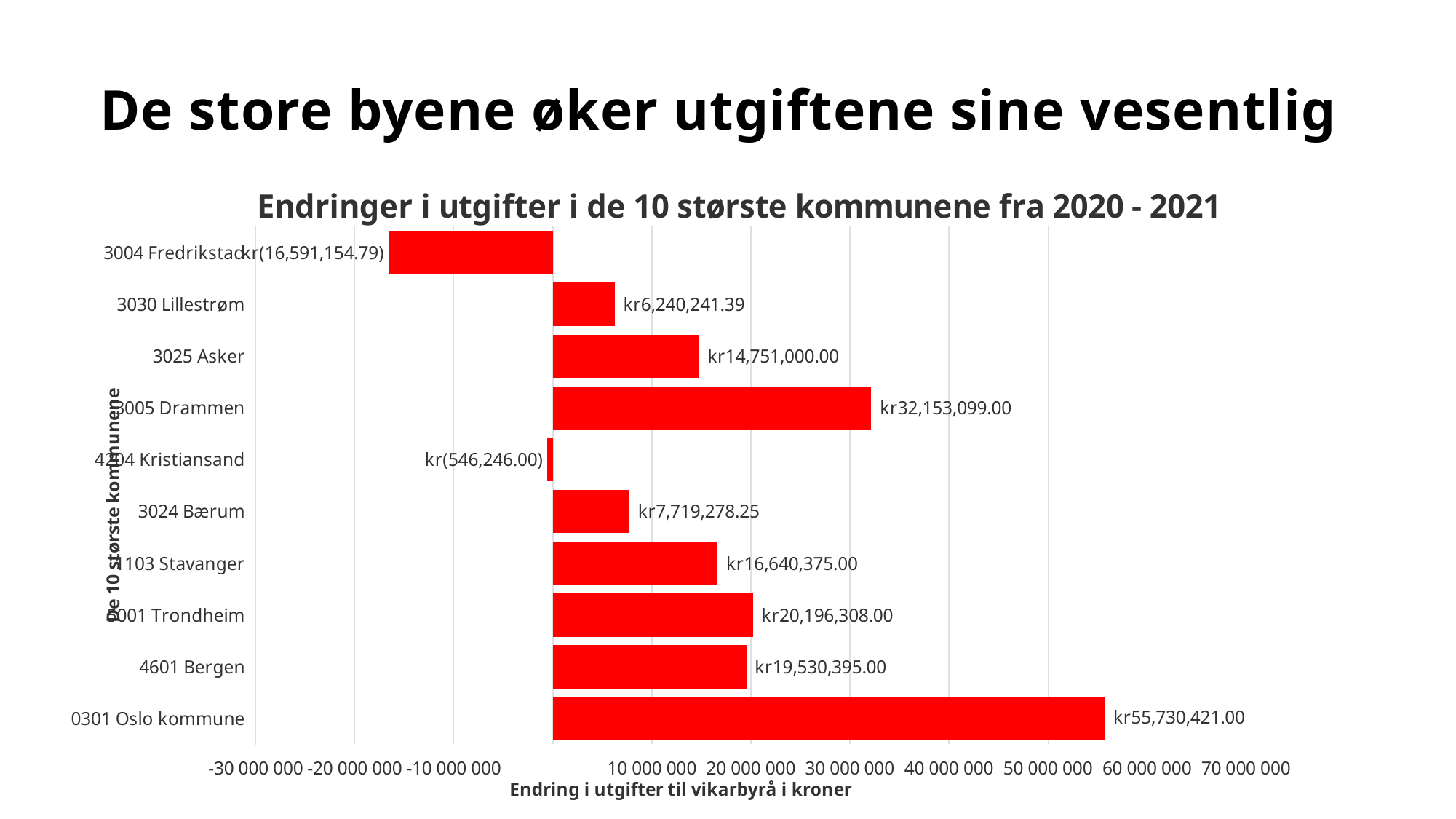
What is the title of the chart? Endringer i utgifter i de 10 største kommunene fra 2020 - 2021 What is the value for 3004 Fredrikstad? kr(16,591,154.79) What is the difference between the values for Trondheim and 4601 Bergen? kr665,913.00 What is the value for 3025 Asker? kr14,751,000.00 Which kommune has the lowest value? 3004 Fredrikstad What is the value for 0301 Oslo kommune? kr55,730,421.00 Is the value for Drammen greater or less than 30 000 000? greater What kind of chart is shown on the slide? Bar chart What is the value for Drammen? kr32,153,099.00 How many kommuner are shown in the chart? 10 Which kommune has the highest value? 0301 Oslo kommune Which is larger, the value for 3025 Asker or the value for Stavanger? Stavanger